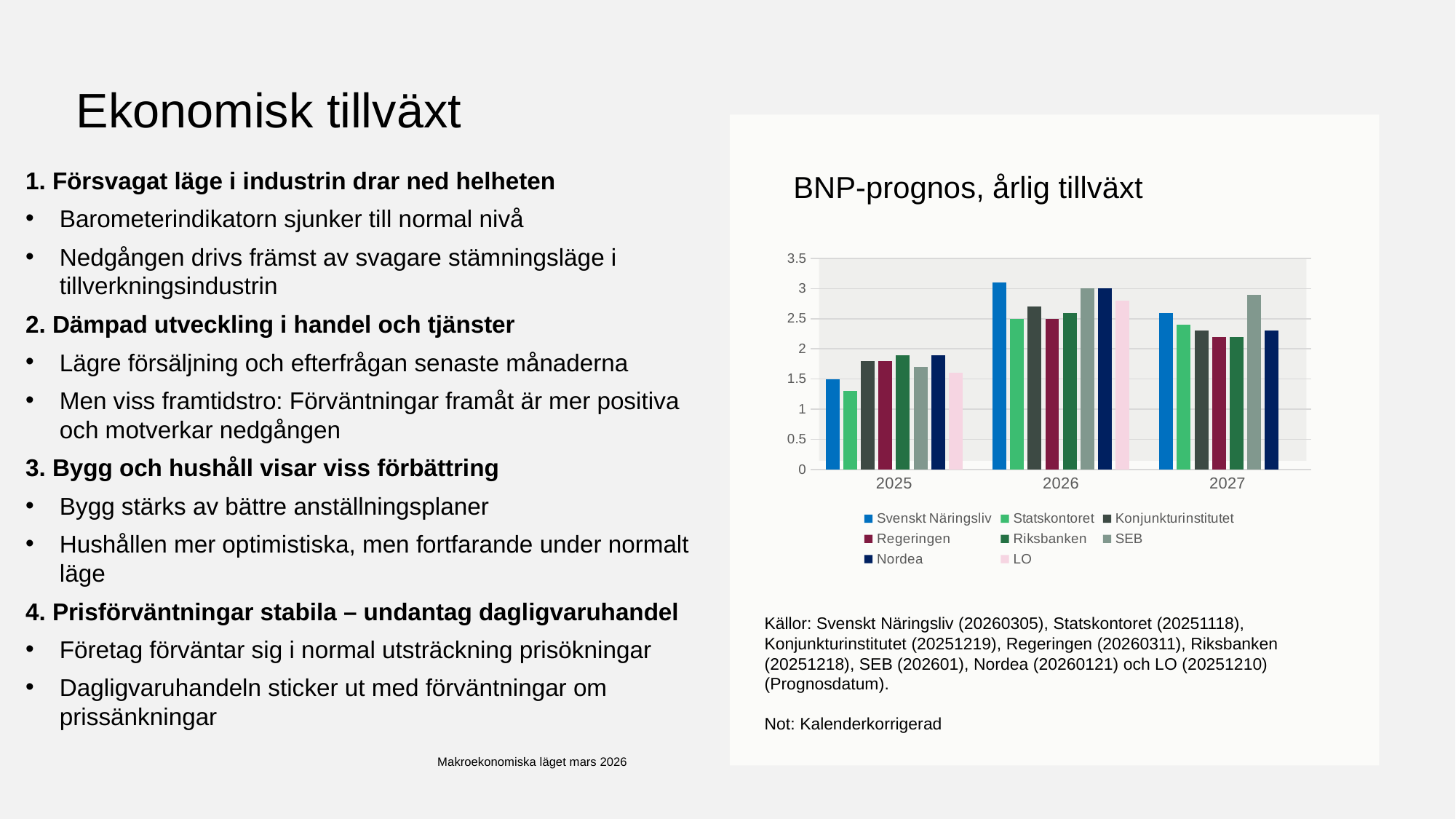
Is the value for Svenskt Näringsliv in 2026 greater or less than 3? greater How many year categories are shown on the x axis? 3 What is the title of the chart? BNP-prognos, årlig tillväxt Is the value for LO in 2026 greater or less than 2.5? greater Which series has the highest bar for 2026? Svenskt Näringsliv What kind of chart is shown on the slide? Bar chart Which series has no bar shown for 2027? LO Which series has the lowest bar for 2025? Statskontoret Which is larger for 2026: Svenskt Näringsliv or Statskontoret? Svenskt Näringsliv Is the value for Statskontoret in 2025 greater or less than 1.5? less How many series does the legend list? 8 Which series has the highest bar for 2027? SEB